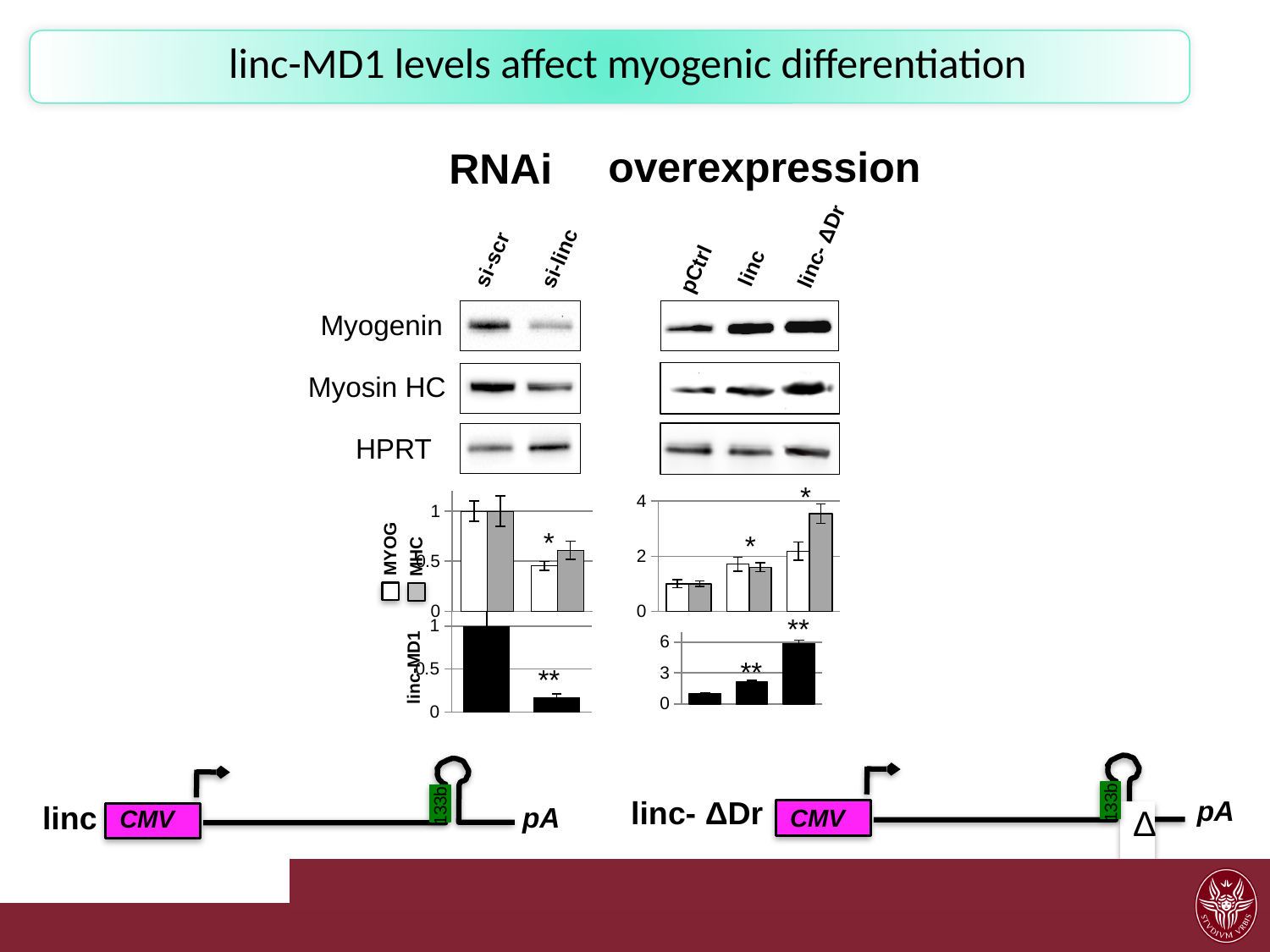
In the overexpression MYOG/MHC bar chart, is the MHC value for linc-ΔDr greater or less than 2? greater In the RNAi MYOG/MHC bar chart, is the MHC value for si-linc greater or less than 0.5? greater In the overexpression MYOG/MHC bar chart (upper right chart), how many categories are shown on the x axis? 3 What kind of chart is the overexpression linc-MD1 chart (lower right chart)? bar chart In the overexpression MYOG/MHC bar chart, do the MYOG values rise or fall from pCtrl to linc-ΔDr? rise In the overexpression linc-MD1 bar chart, which category has the highest value? linc-ΔDr In the RNAi MYOG/MHC bar chart, is the MYOG value for si-scr or for si-linc larger? si-scr In the RNAi linc-MD1 bar chart, is the value for si-linc greater or less than 0.5? less In the RNAi linc-MD1 bar chart (lower left chart), how many categories are shown? 2 In the overexpression MYOG/MHC bar chart, which category has the highest MHC value? linc-ΔDr In the RNAi MYOG/MHC bar chart (upper left chart), how many series does the legend list? 2